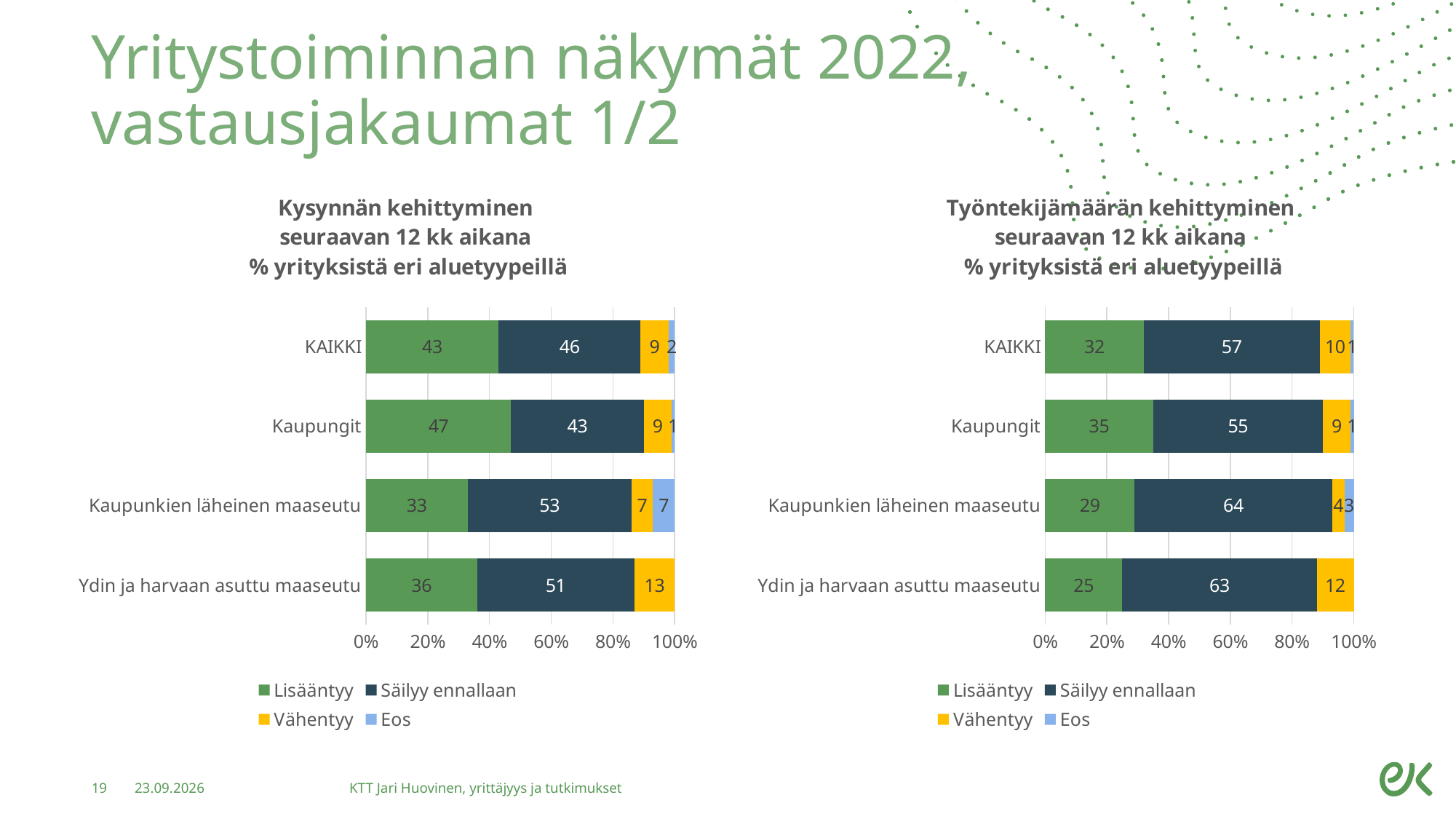
In the left chart (Kysynnän kehittyminen), which colour represents the Vähentyy series? Yellow In the left chart (Kysynnän kehittyminen), which is larger: the Säilyy ennallaan value for Kaupunkien läheinen maaseutu or for KAIKKI? Kaupunkien läheinen maaseutu In the left chart (Kysynnän kehittyminen), what is the Lisääntyy value for Kaupungit? 47 In the left chart (Kysynnän kehittyminen), what is the total of the labelled segments for KAIKKI? 100 In the left chart (Kysynnän kehittyminen), which category has the highest Lisääntyy value? Kaupungit In the right chart (Työntekijämäärän kehittyminen), which category has the lowest Lisääntyy value? Ydin ja harvaan asuttu maaseutu In the right chart (Työntekijämäärän kehittyminen), what is the Säilyy ennallaan value for Kaupunkien läheinen maaseutu? 64 What type of chart is the right chart (Työntekijämäärän kehittyminen)? Stacked bar chart How many categories are shown on the y axis of the left chart (Kysynnän kehittyminen)? 4 How many series does the legend of the right chart (Työntekijämäärän kehittyminen) list? 4 In the left chart (Kysynnän kehittyminen), what is the Vähentyy value for Ydin ja harvaan asuttu maaseutu? 13 In the right chart (Työntekijämäärän kehittyminen), what is the difference between the Säilyy ennallaan values for KAIKKI and Kaupungit? 2